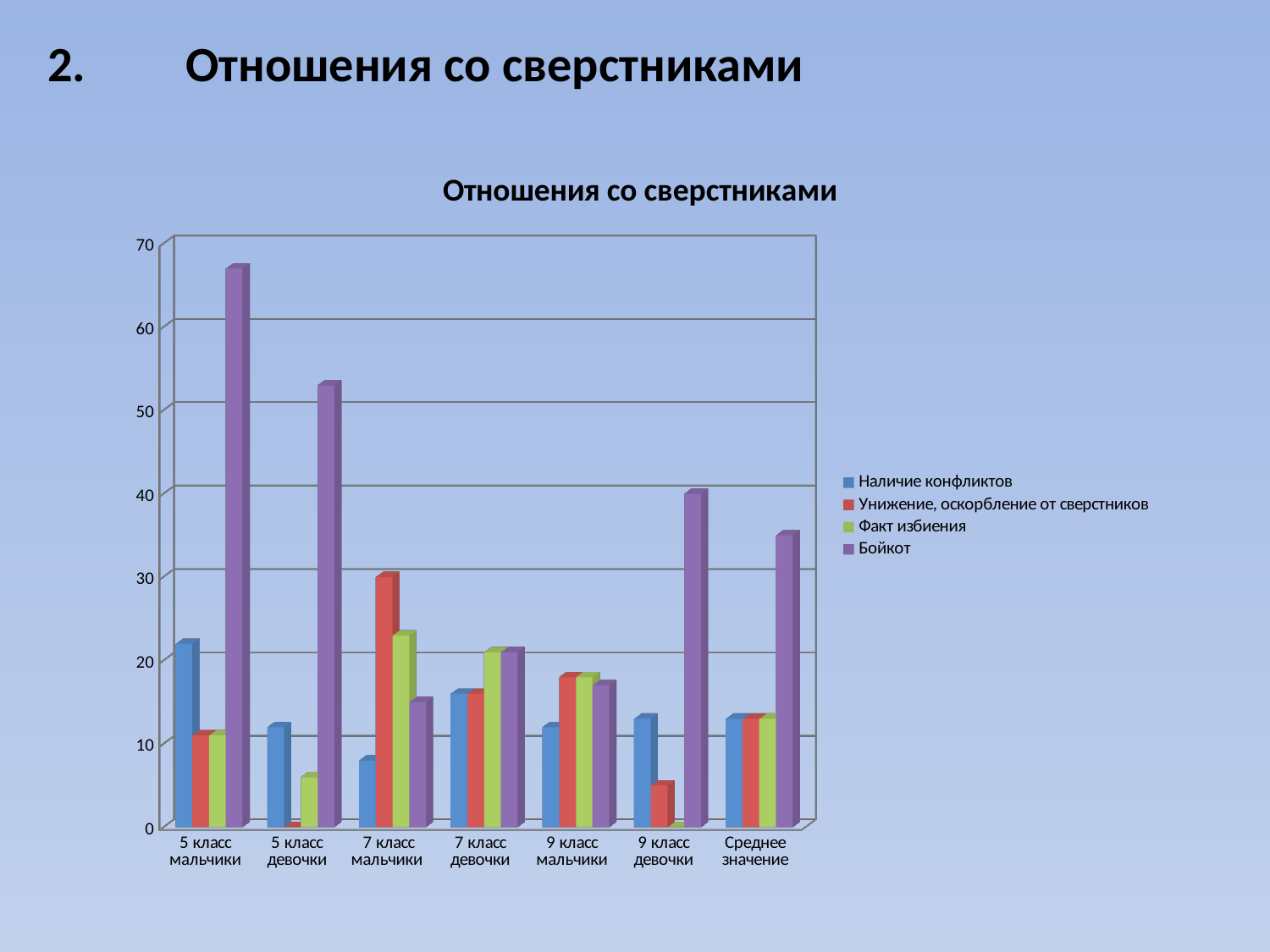
Is the value for Бойкот in 5 класс мальчики greater or less than 60? greater How many series does the legend list? 4 Is the value for Бойкот in Среднее значение greater or less than 30? greater Is the value for Наличие конфликтов in 7 класс мальчики greater or less than 10? less How many categories are shown along the x axis? 7 Which category has the highest value for Бойкот? 5 класс мальчики Which series is shown in purple in the legend? Бойкот Which is larger: the Наличие конфликтов value for 5 класс мальчики or for 7 класс мальчики? 5 класс мальчики Which is larger: the Бойкот value for 5 класс девочки or for 9 класс девочки? 5 класс девочки What kind of chart is shown on the slide? bar chart Which category has the highest value for Унижение, оскорбление от сверстников? 7 класс мальчики